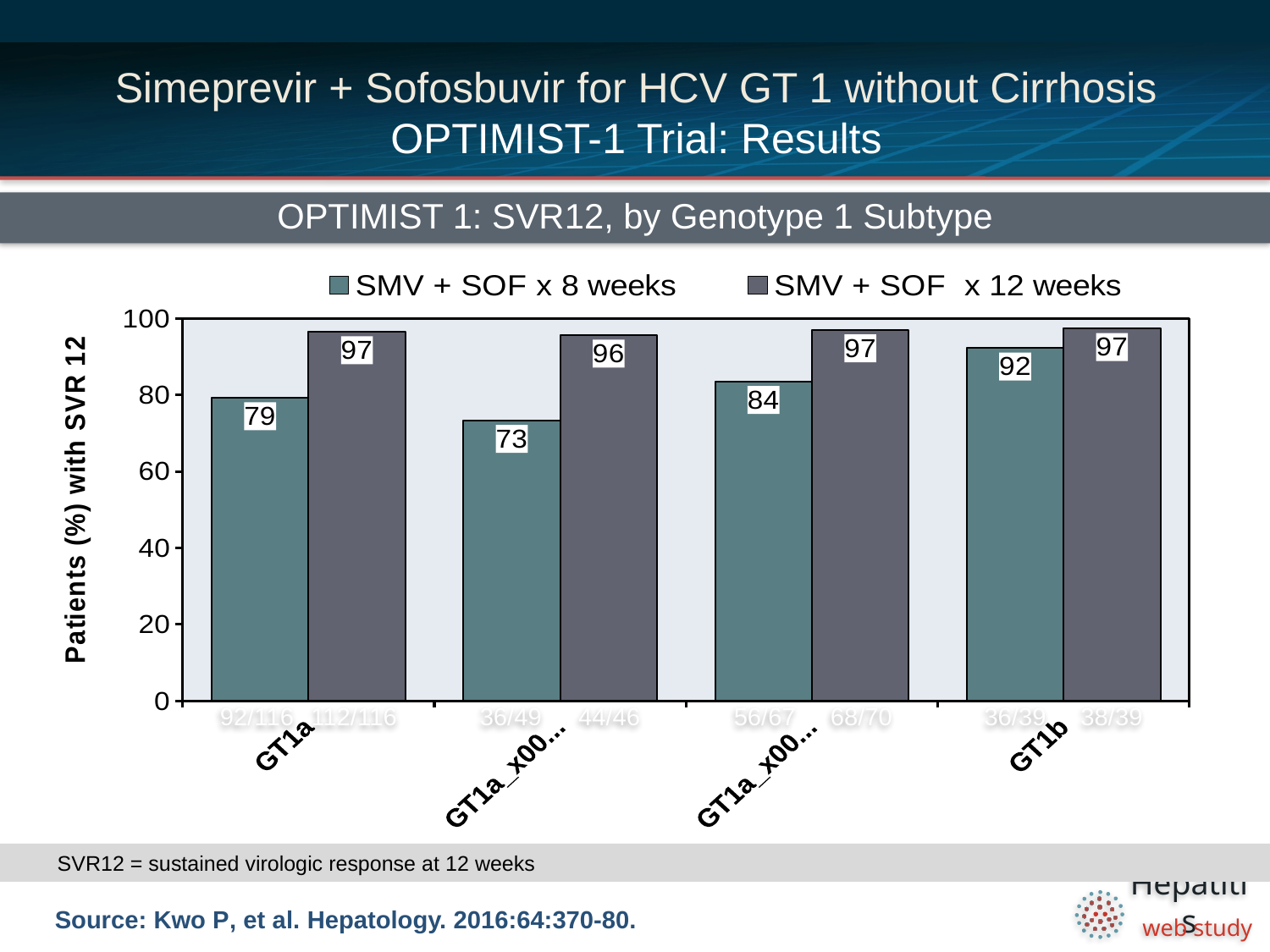
What is the SVR12 rate for GT1a with SMV + SOF x 8 weeks? 79 What is the difference between the 12-week and 8-week SVR12 rates for GT1a? 18 What type of chart is shown on the slide? bar chart What is the SVR12 rate for GT1a with SMV + SOF x 12 weeks? 97 How many series does the legend list? 2 What is the SVR12 rate for GT1b with SMV + SOF x 8 weeks? 92 Which has the higher SVR12 rate with SMV + SOF x 8 weeks, GT1a or GT1b? GT1b What is the SVR12 rate for GT1b with SMV + SOF x 12 weeks? 97 What is the lowest SVR12 value shown for the SMV + SOF x 8 weeks series? 73 How many genotype subtype categories are shown on the x axis? 4 What is the difference between the 12-week and 8-week SVR12 rates for GT1b? 5 What is the label of the y axis? Patients (%) with SVR 12